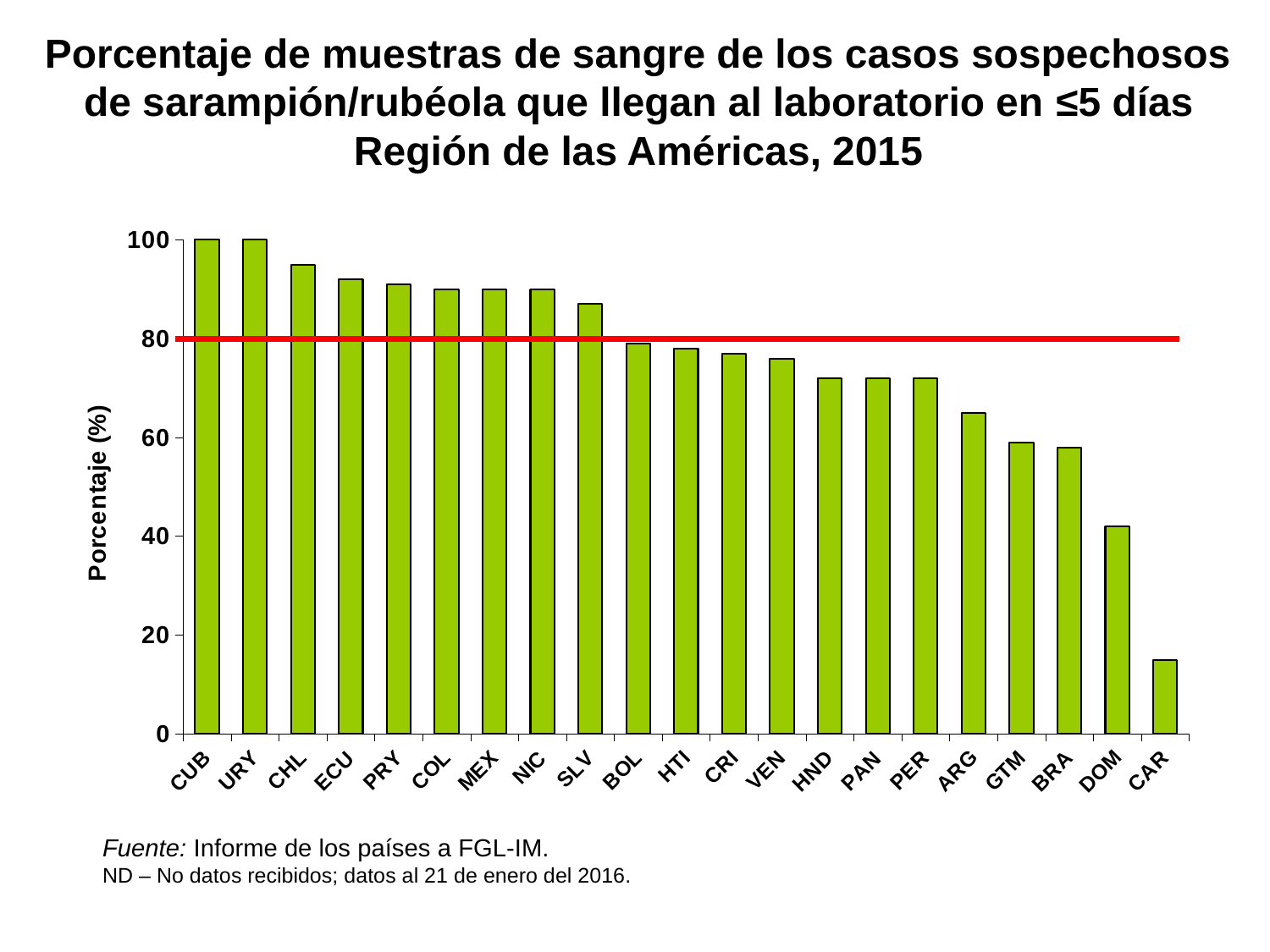
Which is larger, the value for ECU or the value for BRA? ECU Is the value for CAR greater or less than 20? less Which country has the lowest value in the chart? CAR What is the label of the y axis? Porcentaje (%) What is the value for CUB? 100 What is the value for URY? 100 How many countries are shown on the x axis of the chart? 21 Is the value for HND greater or less than 80? less What kind of chart is shown on the slide? bar chart Is the value for CHL greater or less than 80? greater Do the values rise or fall moving from left to right along the x axis? fall